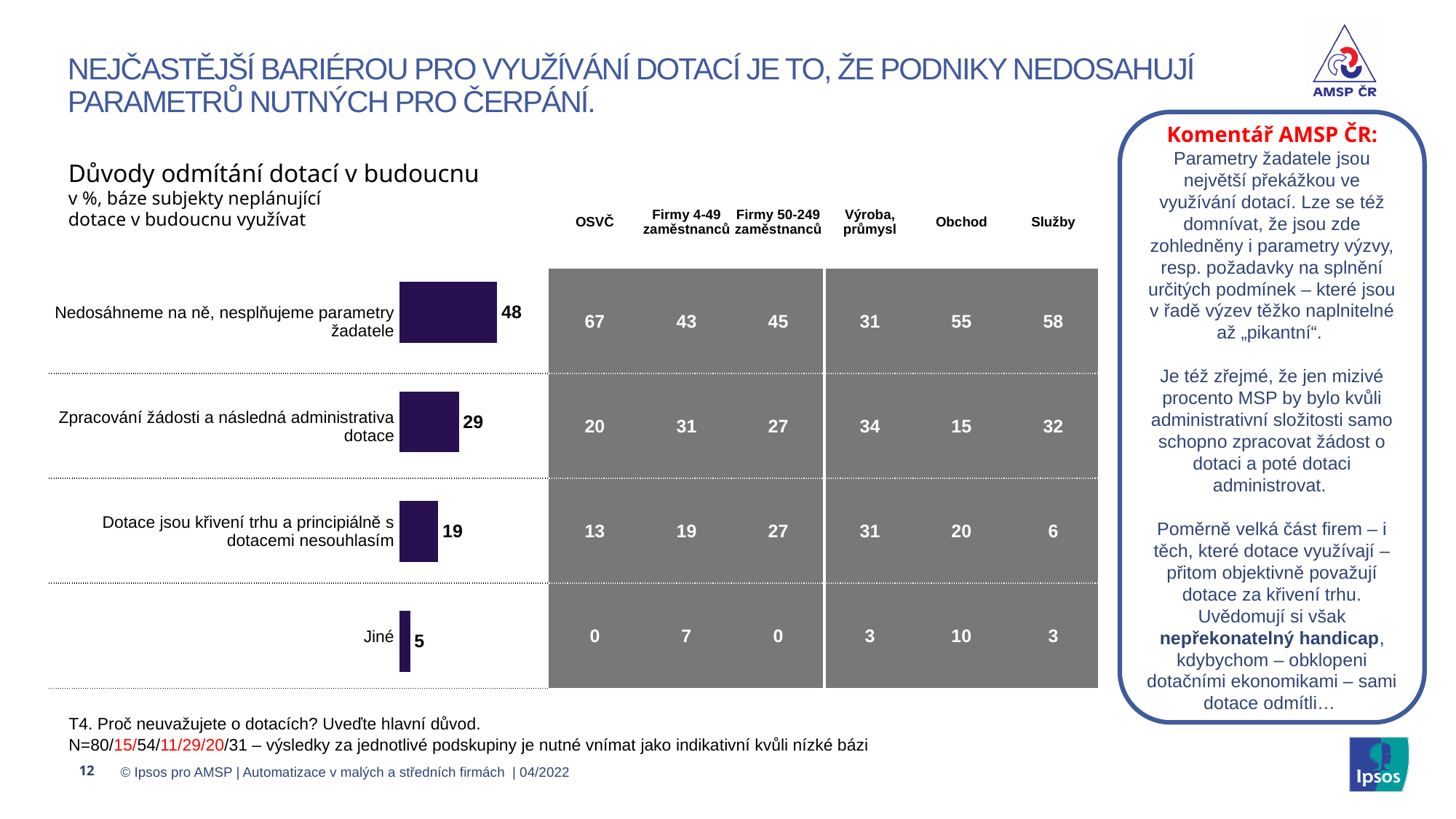
What is the value for "Jiné" in the bar chart? 5 What is the value for "Dotace jsou křivení trhu a principiálně s dotacemi nesouhlasím" in the bar chart? 19 What is the value for "Nedosáhneme na ně, nesplňujeme parametry žadatele" in the bar chart? 48 In what unit are the values in the chart expressed, according to the subtitle? % What kind of chart is shown on the slide? Bar chart Which is larger: the value for "Dotace jsou křivení trhu a principiálně s dotacemi nesouhlasím" or the value for "Jiné"? Dotace jsou křivení trhu a principiálně s dotacemi nesouhlasím Which category has the lowest value in the bar chart? Jiné What is the difference between the values for "Nedosáhneme na ně, nesplňujeme parametry žadatele" and "Zpracování žádosti a následná administrativa dotace"? 19 What is the title of the chart? Důvody odmítání dotací v budoucnu Which category has the highest value in the bar chart? Nedosáhneme na ně, nesplňujeme parametry žadatele What is the value for "Zpracování žádosti a následná administrativa dotace" in the bar chart? 29 How many categories are shown in the bar chart? 4